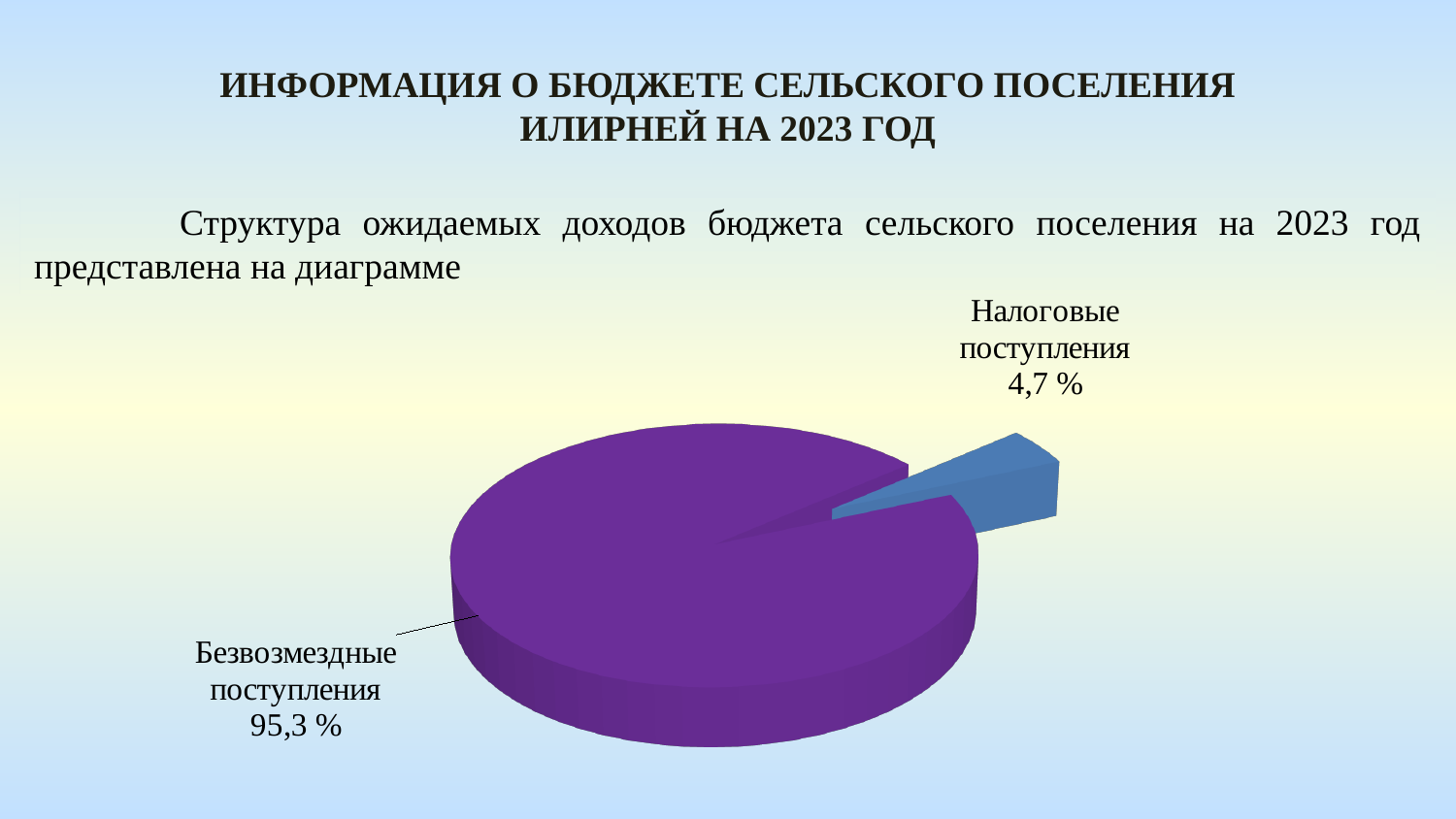
What is the difference in percentage points between Безвозмездные поступления and Налоговые поступления? 90,6 What share of the pie does Налоговые поступления represent? 4,7 % What share of the pie does Безвозмездные поступления represent? 95,3 % Which category has the smallest slice of the pie? Налоговые поступления How many slices does the pie chart have? 2 Which category has the largest slice of the pie? Безвозмездные поступления Which is larger, Налоговые поступления or Безвозмездные поступления? Безвозмездные поступления What kind of chart is shown on the slide? Pie chart What colour is the slice for Безвозмездные поступления? Purple What colour is the slice for Налоговые поступления? Blue